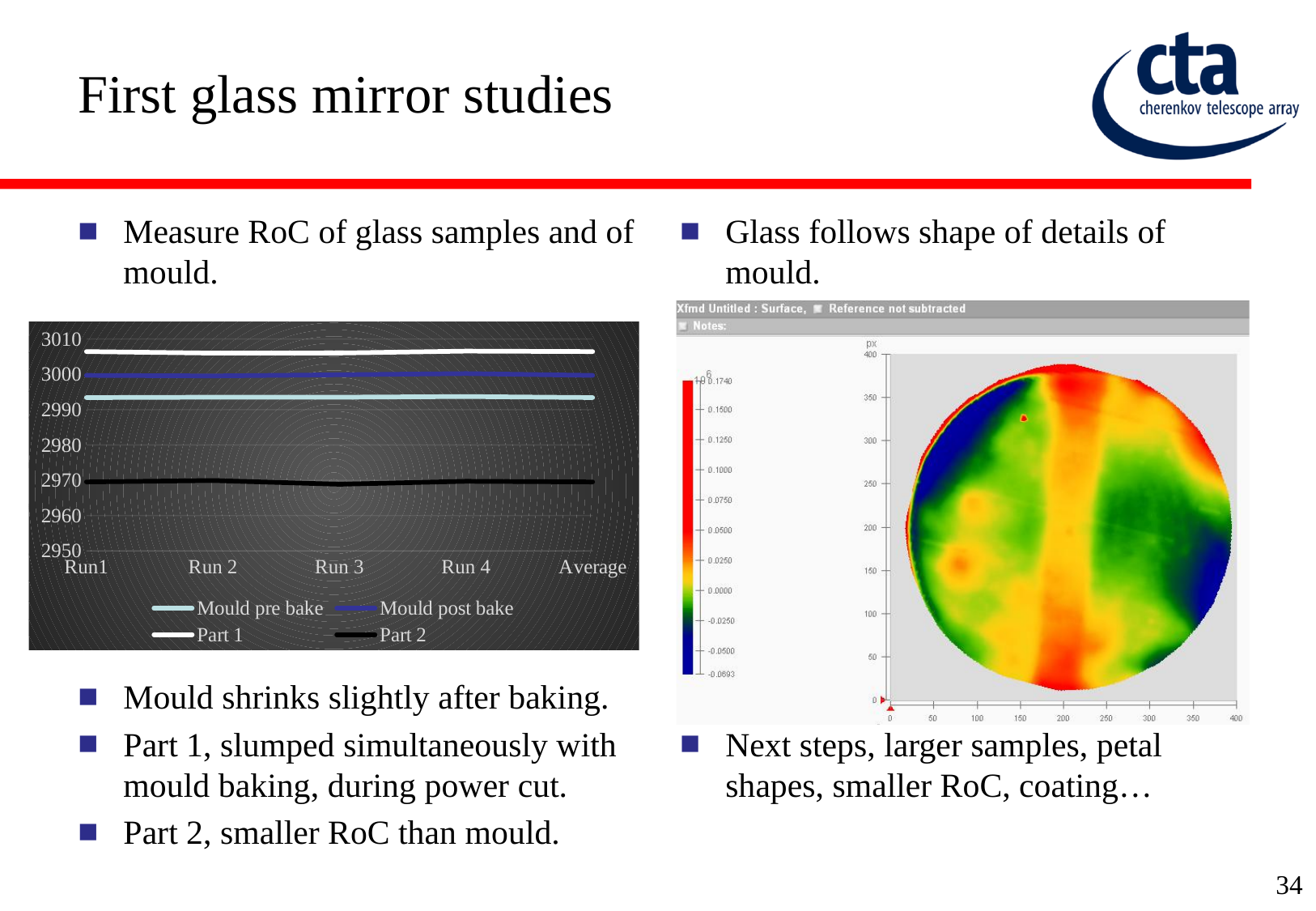
What kind of chart is shown on the left of the slide? line chart How many categories are shown along the x axis of the line chart? 5 In the line chart, is the value for Part 1 at Average greater or less than 2990? greater In the line chart, which is larger at Run 4: Part 1 or Part 2? Part 1 How many series does the legend of the line chart list? 4 Which series in the line chart has the lowest values? Part 2 Which series in the line chart has the highest values? Part 1 In the line chart, is the value for Part 2 at Average greater or less than 2980? less In the line chart, which is larger at Run 3: Mould pre bake or Mould post bake? Mould post bake In the line chart, is the value for Part 1 at Run1 greater or less than 3000? greater What colour is the Part 2 line in the line chart? black